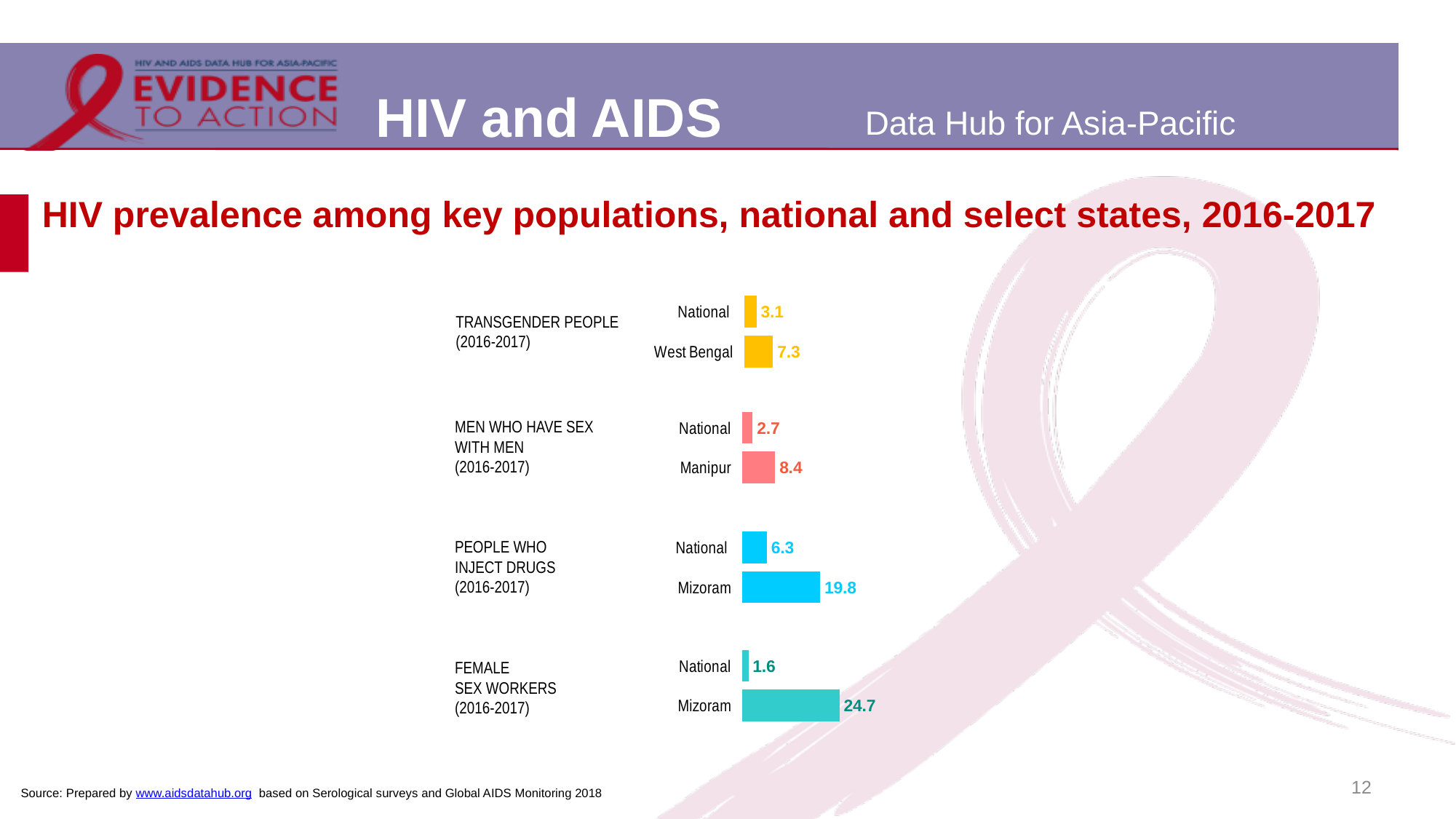
What colour are the bars for people who inject drugs? Blue What is the difference between the Mizoram and national HIV prevalence among people who inject drugs? 13.5 How many bars are plotted on the chart in total? 8 Which bar on the chart has the lowest value? Female sex workers, National (1.6) What is the national HIV prevalence among men who have sex with men? 2.7 What is the HIV prevalence among transgender people in West Bengal? 7.3 Which is larger: the national HIV prevalence among transgender people or among people who inject drugs? People who inject drugs (6.3) What is the difference between the Manipur and national HIV prevalence among men who have sex with men? 5.7 What type of chart is shown on the slide? Bar chart What is the national HIV prevalence among female sex workers? 1.6 What is the HIV prevalence among people who inject drugs in Mizoram? 19.8 Which bar on the chart has the highest value? Female sex workers, Mizoram (24.7)